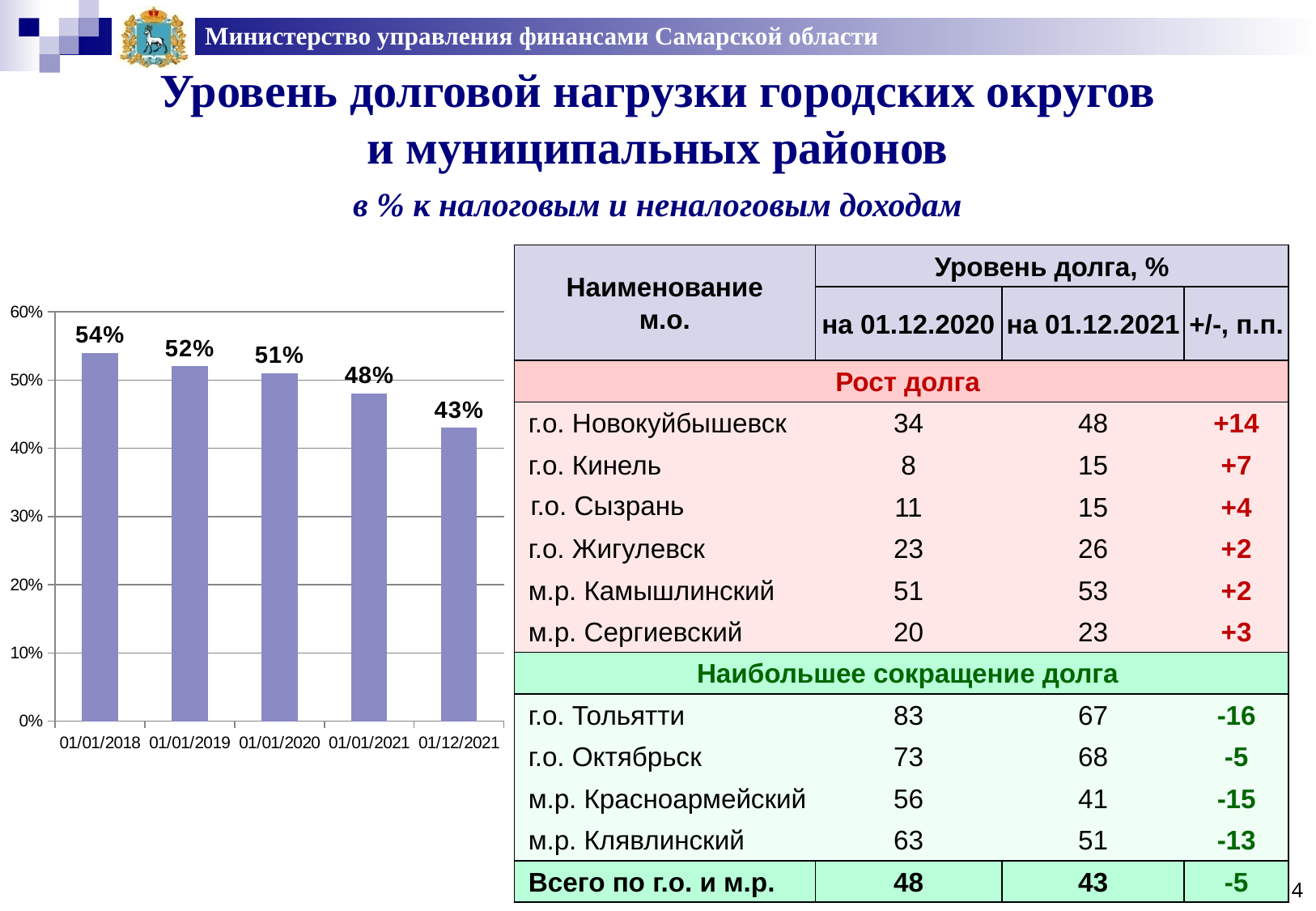
Which is larger in the bar chart: the value for 01/01/2019 or the value for 01/01/2021? 01/01/2019 Is the value for 01/01/2021 in the bar chart greater or less than 50%? less What kind of chart is shown on the left of the slide? bar chart What is the difference between the values for 01/01/2019 and 01/01/2021 in the bar chart? 4 percentage points What is the value for 01/12/2021 in the bar chart? 43% How many bars are shown in the bar chart? 5 What is the value for 01/01/2018 in the bar chart? 54% Which date has the lowest value in the bar chart? 01/12/2021 Which date has the highest value in the bar chart? 01/01/2018 Do the values in the bar chart rise or fall from 01/01/2018 to 01/12/2021? fall What is the difference between the values for 01/01/2018 and 01/12/2021 in the bar chart? 11 percentage points What is the value for 01/01/2020 in the bar chart? 51%